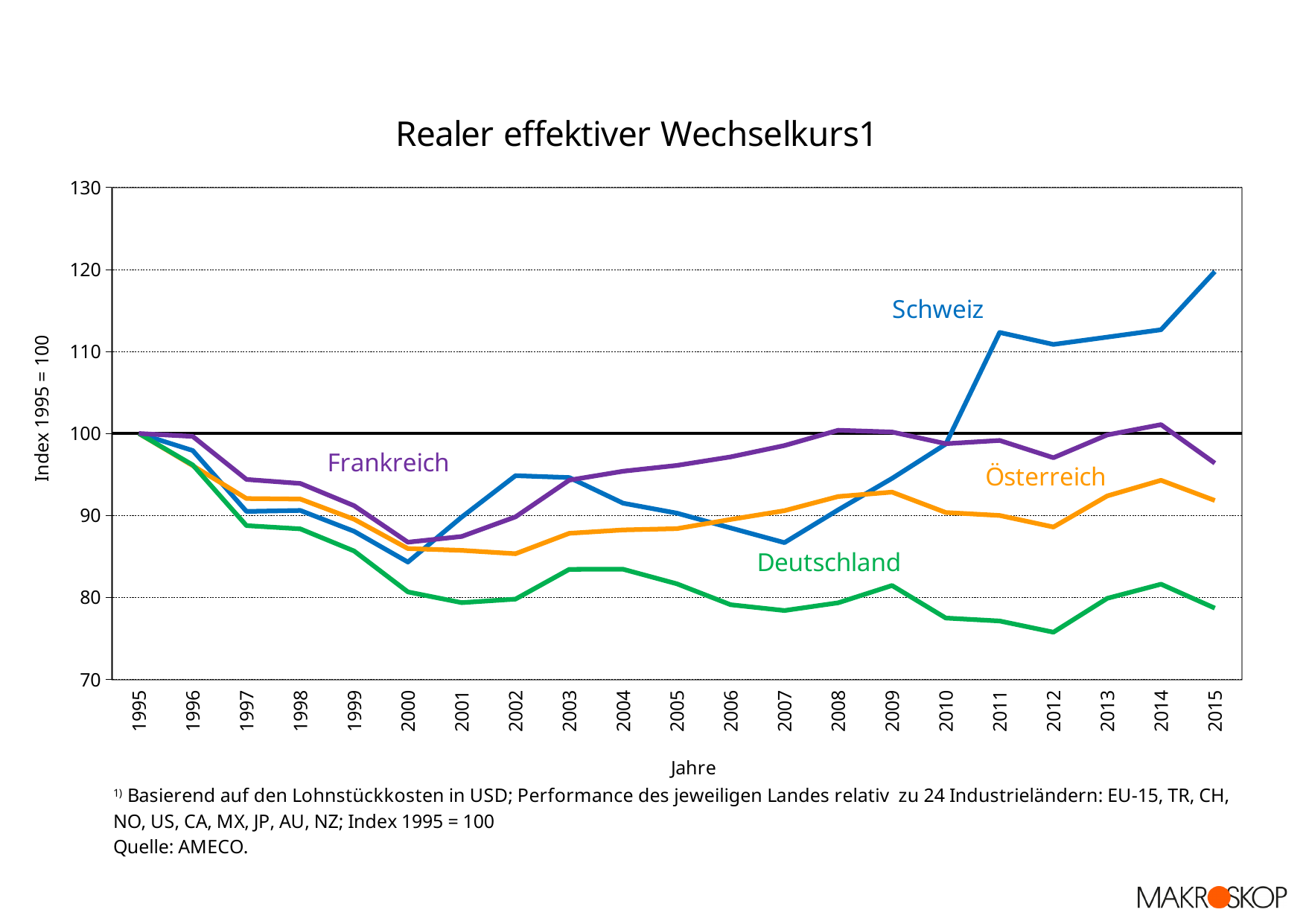
Which country has the highest value in 2015? Schweiz Is the value for Frankreich in 2000 greater or less than 90? less What is the index value for Schweiz in 1995? 100 How many years are shown on the x axis? 21 What is the label of the y axis? Index 1995 = 100 Is the value for Schweiz in 2015 greater or less than 110? greater Which country has the lowest value in 2015? Deutschland What kind of chart is shown on the slide? line chart Which is larger in 2012, the value for Frankreich or the value for Österreich? Frankreich How many countries (series) are plotted in the chart? 4 Is the value for Deutschland in 2012 greater or less than 80? less Does the value for Schweiz rise or fall from 2010 to 2015? rise